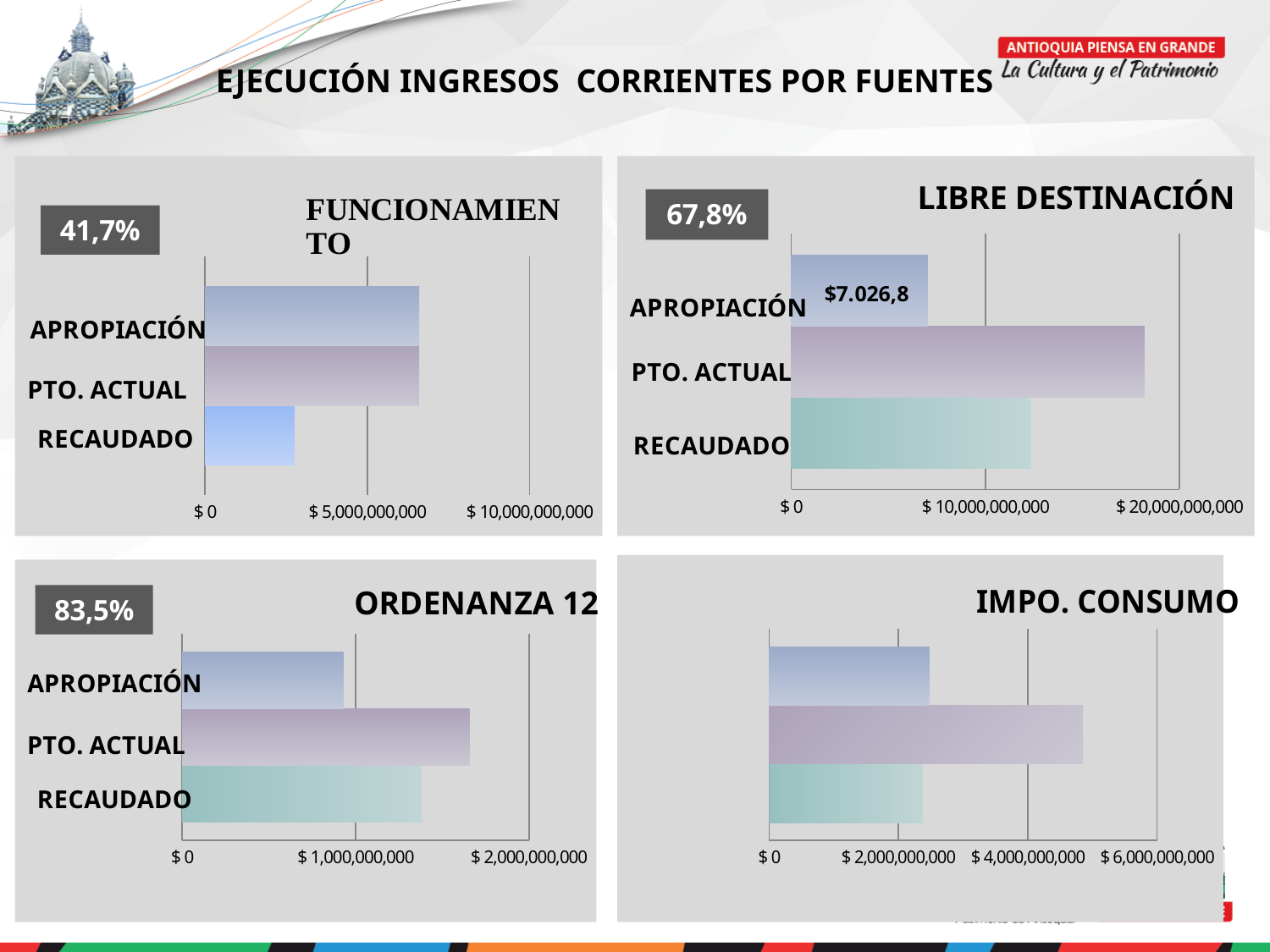
In the LIBRE DESTINACIÓN chart, what value is labelled on the APROPIACIÓN bar? $7.026,8 What type of chart is the FUNCIONAMIENTO chart? bar chart What percentage is shown next to the ORDENANZA 12 chart? 83,5% How many categories are shown in the IMPO. CONSUMO chart? 3 In the LIBRE DESTINACIÓN chart, which category has the highest value? PTO. ACTUAL In the ORDENANZA 12 chart, is the value for RECAUDADO greater or less than $ 1,000,000,000? greater In the LIBRE DESTINACIÓN chart, which category has the lowest value? APROPIACIÓN In the IMPO. CONSUMO chart, which category has the highest value? PTO. ACTUAL In the FUNCIONAMIENTO chart, which category has the lowest value? RECAUDADO In the FUNCIONAMIENTO chart, is the value for RECAUDADO greater or less than $ 5,000,000,000? less In the LIBRE DESTINACIÓN chart, is the value for RECAUDADO greater or less than $ 10,000,000,000? greater In the ORDENANZA 12 chart, which is larger, PTO. ACTUAL or RECAUDADO? PTO. ACTUAL